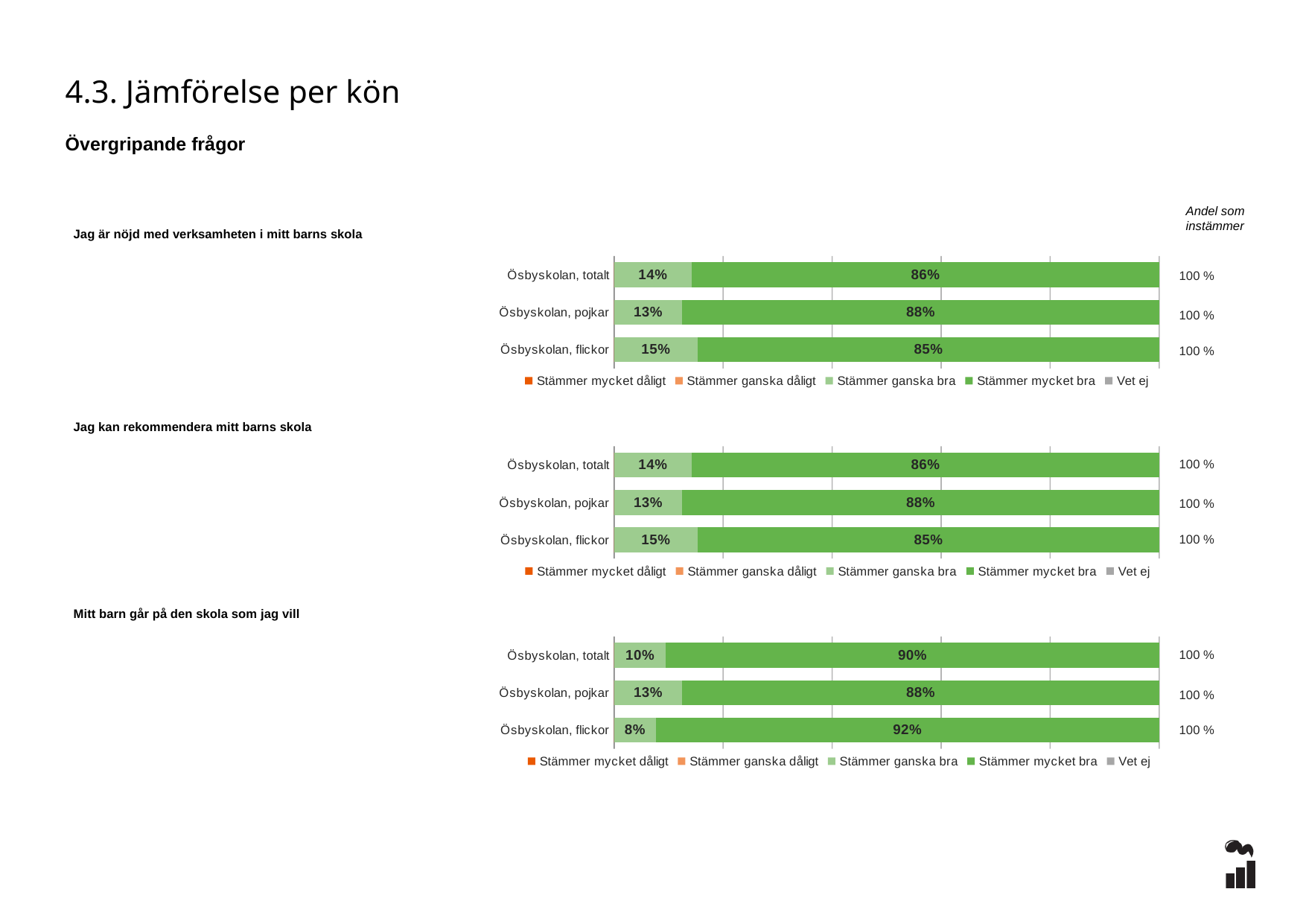
In the chart 'Jag är nöjd med verksamheten i mitt barns skola', what is the 'Stämmer ganska bra' value for Ösbyskolan, flickor? 15% In the chart 'Mitt barn går på den skola som jag vill', what is the 'Stämmer mycket bra' value for Ösbyskolan, flickor? 92% In the chart 'Jag är nöjd med verksamheten i mitt barns skola', what is the 'Stämmer mycket bra' value for Ösbyskolan, pojkar? 88% In the chart 'Jag kan rekommendera mitt barns skola', which is larger: the 'Stämmer ganska bra' value for Ösbyskolan, pojkar or for Ösbyskolan, flickor? Ösbyskolan, flickor In the chart 'Mitt barn går på den skola som jag vill', which category has the highest 'Stämmer mycket bra' value? Ösbyskolan, flickor In the chart 'Mitt barn går på den skola som jag vill', what is the difference between the 'Stämmer mycket bra' values for Ösbyskolan, flickor and Ösbyskolan, pojkar? 4% How many categories are shown in the chart 'Jag är nöjd med verksamheten i mitt barns skola'? 3 What kind of chart is 'Jag kan rekommendera mitt barns skola'? Stacked bar chart How many series does the legend of the chart 'Mitt barn går på den skola som jag vill' list? 5 In the chart 'Jag är nöjd med verksamheten i mitt barns skola', what is the total of the stacked bar for Ösbyskolan, totalt? 100% In the chart 'Mitt barn går på den skola som jag vill', what is the 'Stämmer ganska bra' value for Ösbyskolan, totalt? 10% In the chart 'Jag kan rekommendera mitt barns skola', which category has the lowest 'Stämmer mycket bra' value? Ösbyskolan, flickor